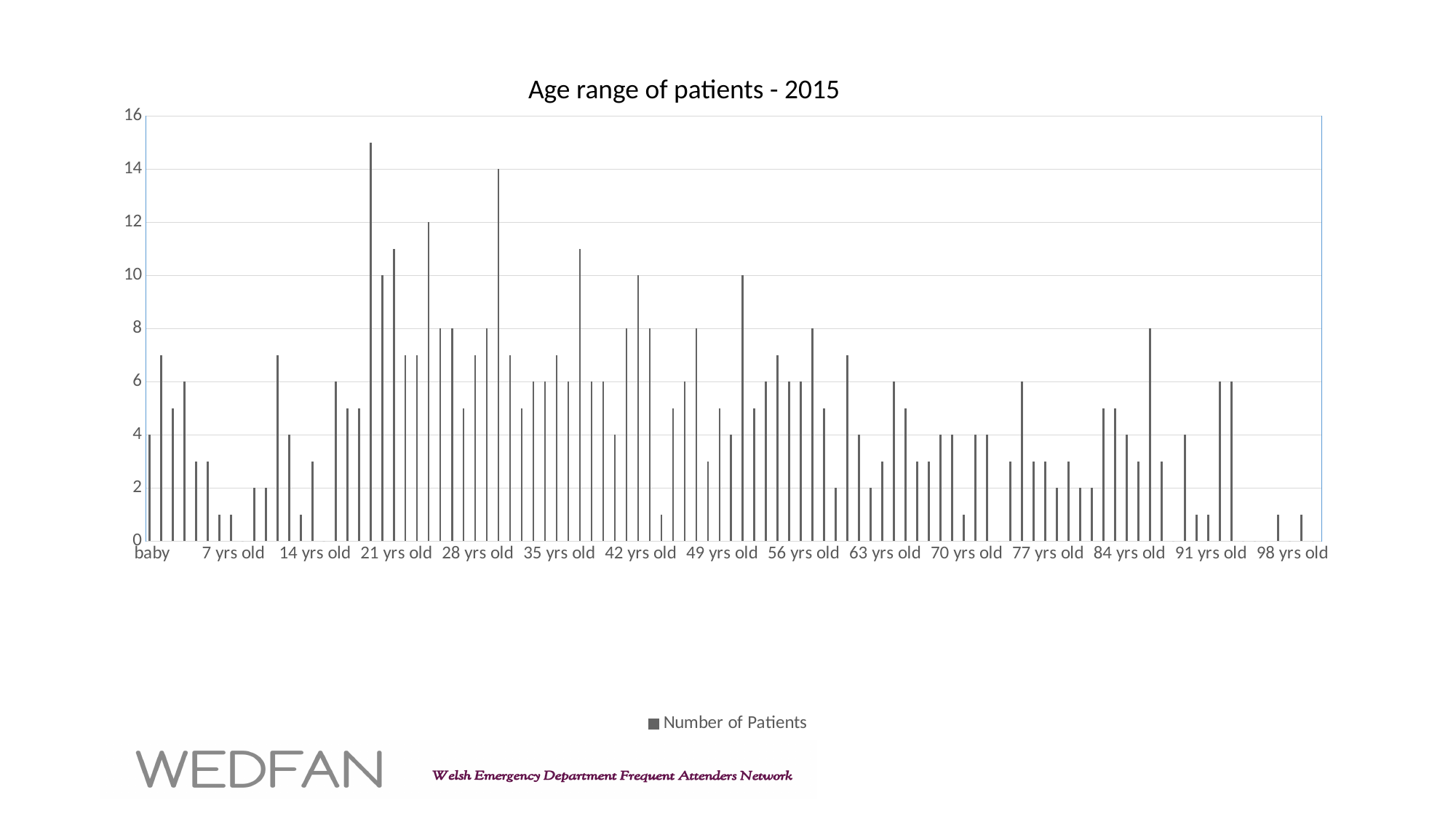
Which has more patients, 42 yrs old or 98 yrs old? 42 yrs old Is the value for 7 yrs old greater or less than 2? less Is the value for 98 yrs old greater or less than 2? less What is the title of the chart? Age range of patients - 2015 What is the name of the series shown in the legend? Number of Patients Is the value for 21 yrs old greater or less than 8? greater What type of chart is shown on the slide? bar chart Which has more patients, baby or 7 yrs old? baby How many series does the legend list? 1 What is the number of patients for the 'baby' category? 4